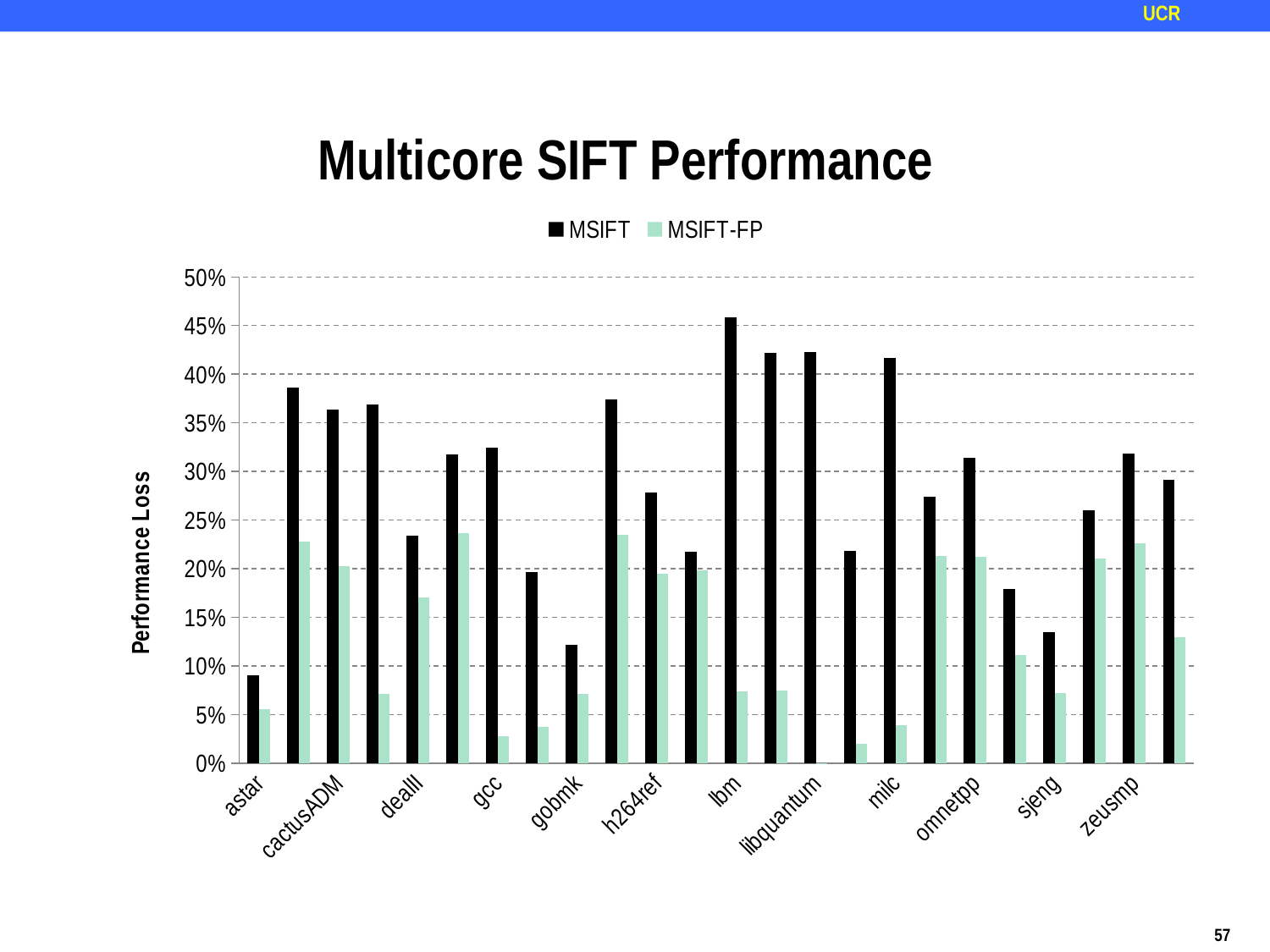
What is the label on the vertical axis? Performance Loss How many series does the legend list? 2 What is the highest value shown on the vertical axis? 50% What kind of chart is shown on the slide? bar chart How many benchmark labels are printed along the x axis? 12 Which series generally shows the higher performance loss across the benchmarks, MSIFT or MSIFT-FP? MSIFT For astar, which series has the larger value, MSIFT or MSIFT-FP? MSIFT Is the MSIFT value for astar greater or less than 10%? less What are the two series named in the legend? MSIFT and MSIFT-FP Is the MSIFT-FP value for astar greater or less than 10%? less What is the title of the chart? Multicore SIFT Performance Is the highest MSIFT value on the chart greater or less than 40%? greater